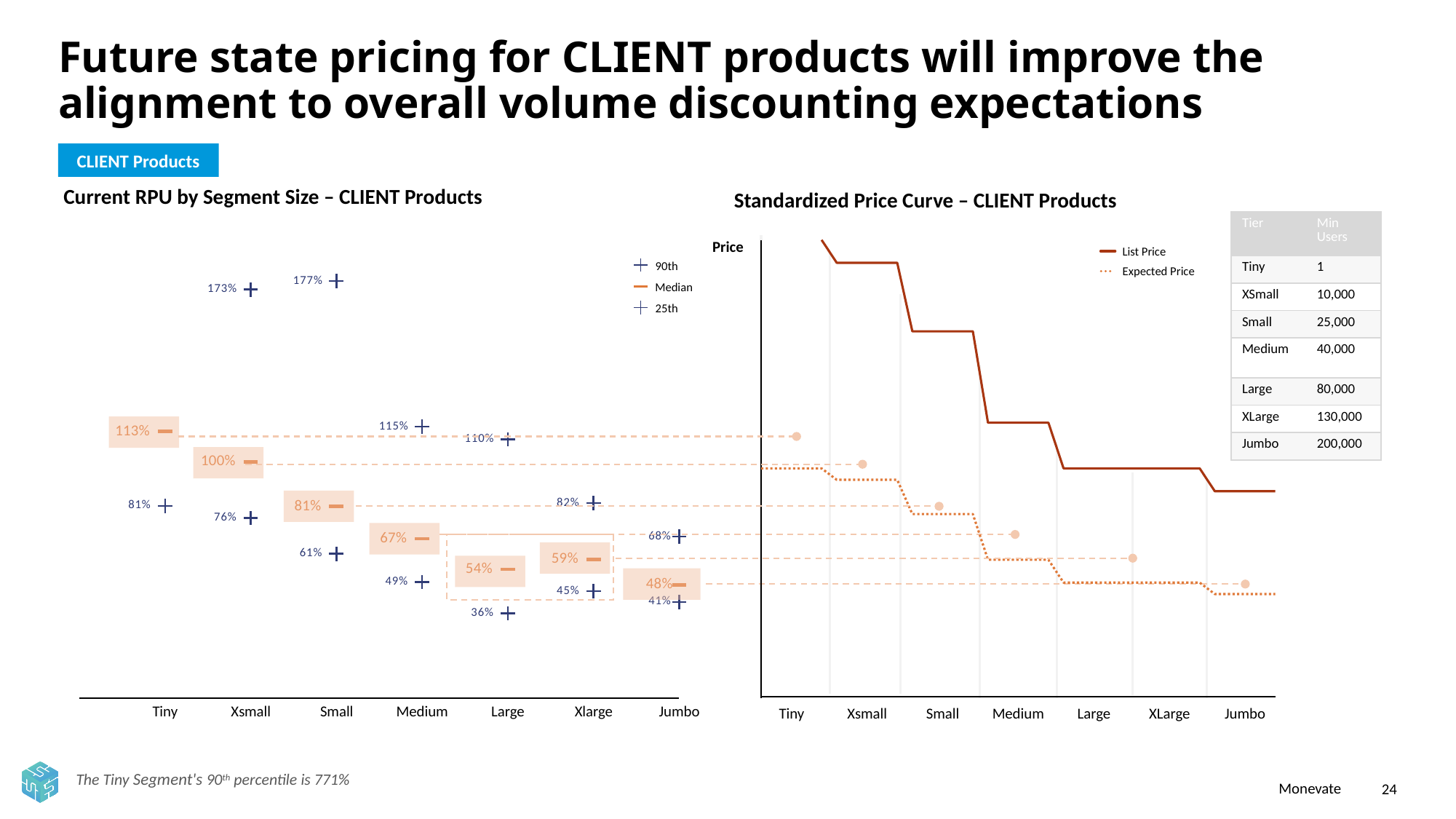
How many series does the legend of the Current RPU by Segment Size chart list? 3 In the Current RPU by Segment Size chart, what is the Median value for the Xsmall segment? 100% In the Current RPU by Segment Size chart, what is the difference between the Median values for Xsmall and Jumbo? 52 percentage points In the Standardized Price Curve chart, does the List Price rise or fall as the segments move from Tiny to Jumbo? Fall In the Current RPU by Segment Size chart, which has the larger Median value, Medium or Xlarge? Medium In the Current RPU by Segment Size chart, which segment has the highest Median value? Tiny According to the footnote, what is the Tiny segment's 90th percentile value? 771% In the Current RPU by Segment Size chart, what is the 25th percentile value for the Large segment? 36% What kind of chart is the Standardized Price Curve – CLIENT Products chart? Line chart In the Current RPU by Segment Size chart, which segment has the lowest Median value? Jumbo How many segment categories are shown on the x axis of the Current RPU by Segment Size chart? 7 In the Current RPU by Segment Size chart, what is the 90th percentile value for the Small segment? 177%